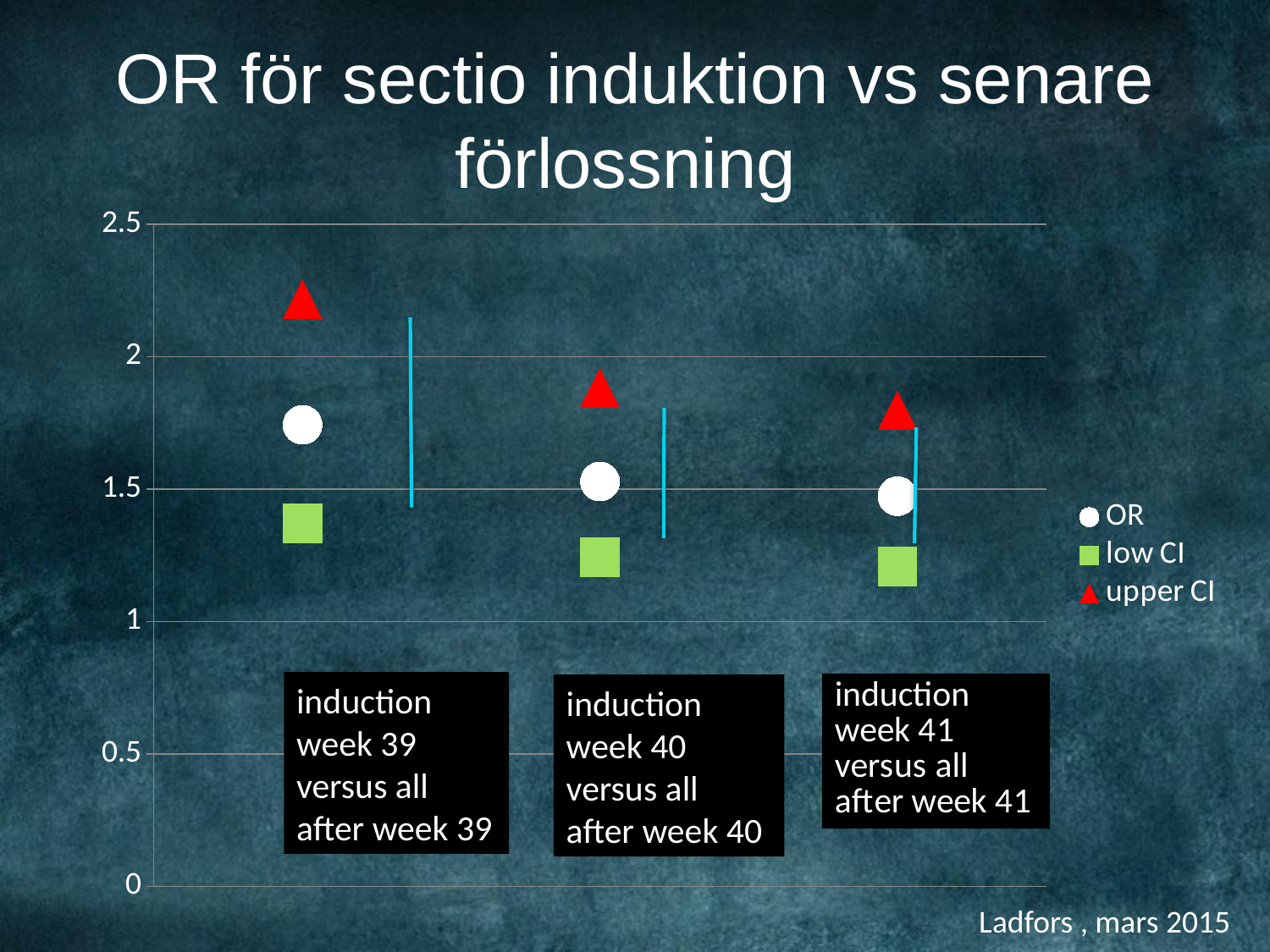
What marker shape and colour represents the upper CI series in the legend? red triangle Is the low CI value for induction week 40 greater or less than 1.5? less How many series does the legend list? 3 Is the upper CI value for induction week 40 greater or less than 2? less Do the OR values rise or fall from induction week 39 to induction week 41? fall Is the upper CI value for induction week 39 greater or less than 2? greater Which induction week has the highest upper CI value? induction week 39 versus all after week 39 Which is larger, the OR for induction week 39 or the OR for induction week 40? induction week 39 Which induction week has the highest OR value? induction week 39 versus all after week 39 What kind of chart is shown on the slide? scatter chart How many induction-week categories are plotted on the chart? 3